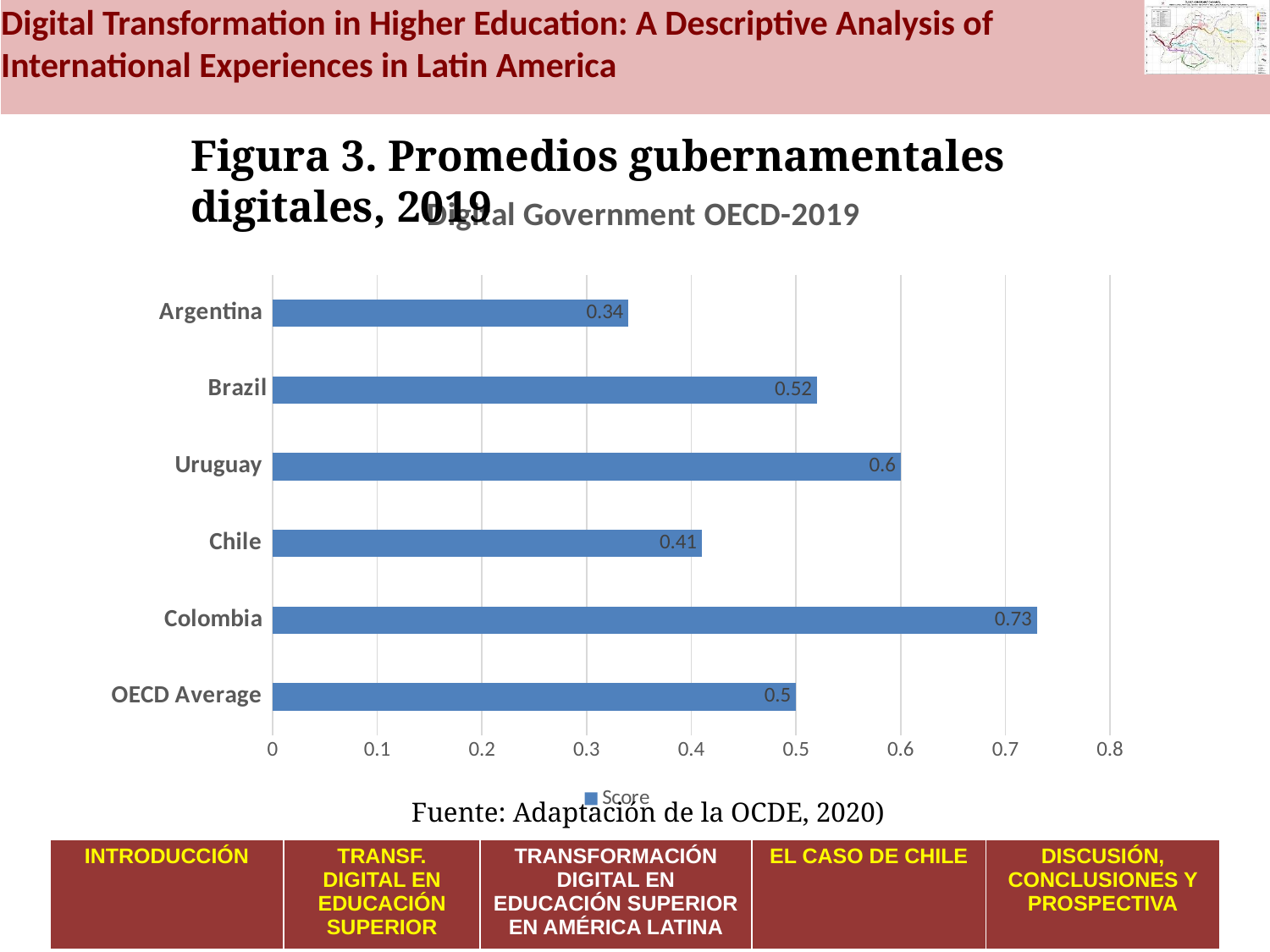
What kind of chart is shown on the slide? Bar chart Which category has the highest score? Colombia What is the title of the chart? Digital Government OECD-2019 Is the value for Uruguay greater or less than 0.5? greater What is the OECD Average score shown in the chart? 0.5 What is the difference between Uruguay's score and the OECD Average? 0.1 Which has a higher score, Brazil or Chile? Brazil How many categories are shown in the chart? 6 Which category has the lowest score? Argentina What is the score for Argentina? 0.34 What is the score for Colombia? 0.73 What is the difference between the scores of Colombia and Chile? 0.32